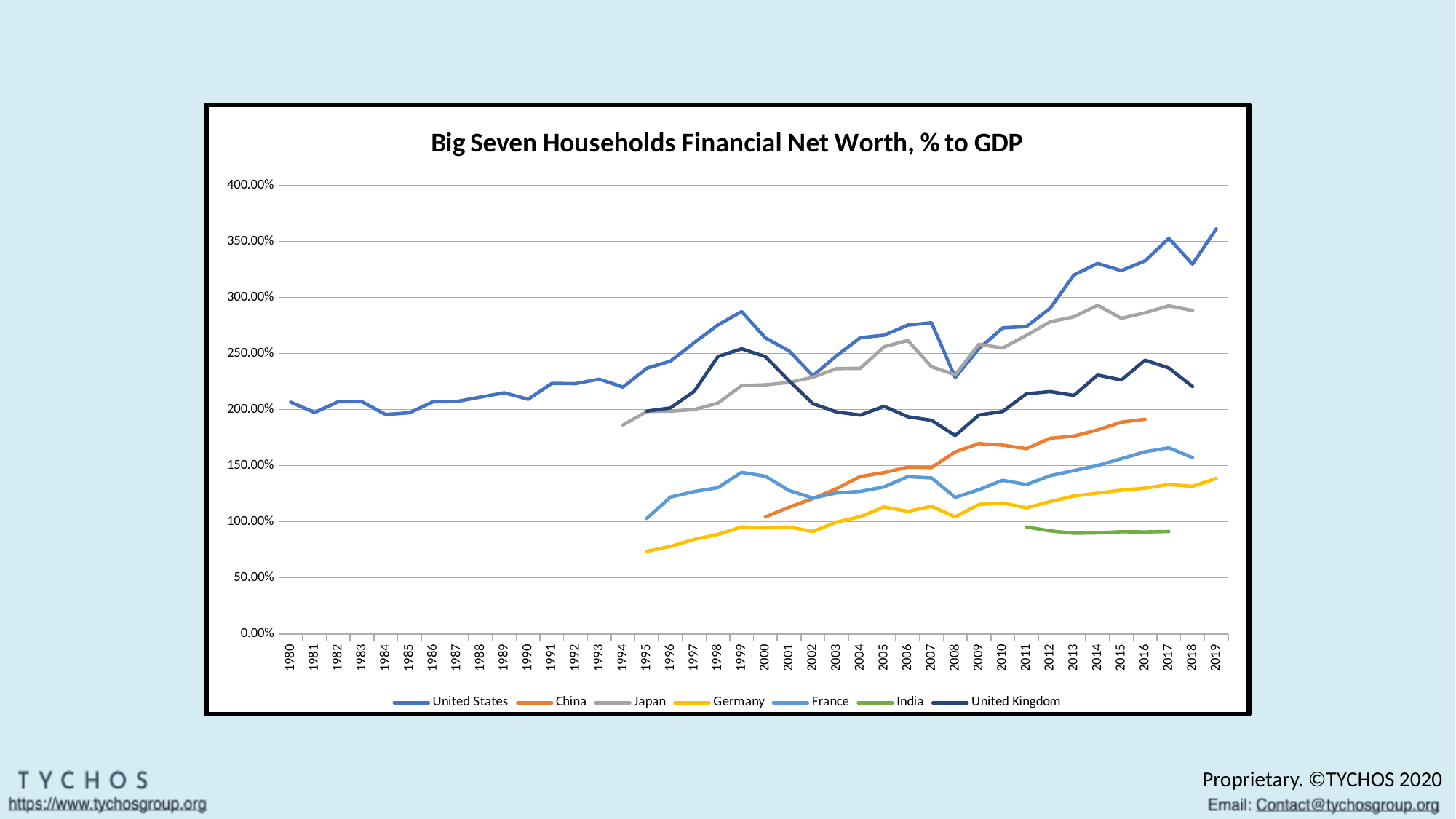
Which series has the highest value in 2019? United States How many series does the legend list? 7 What kind of chart is shown on the slide? line chart In 2014, which is larger: the value for Japan or the value for the United Kingdom? Japan Is the value for Germany in 1995 greater or less than 100.00%? less Is the value for the United States in 2019 greater or less than 350.00%? greater What is the title of the chart? Big Seven Households Financial Net Worth, % to GDP Is the value for the United Kingdom in 2008 greater or less than 200.00%? less Does the value for China rise or fall from 2000 to 2016? rise Which series has the lowest value in 2016? India In 2018, which is larger: the value for France or the value for Germany? France